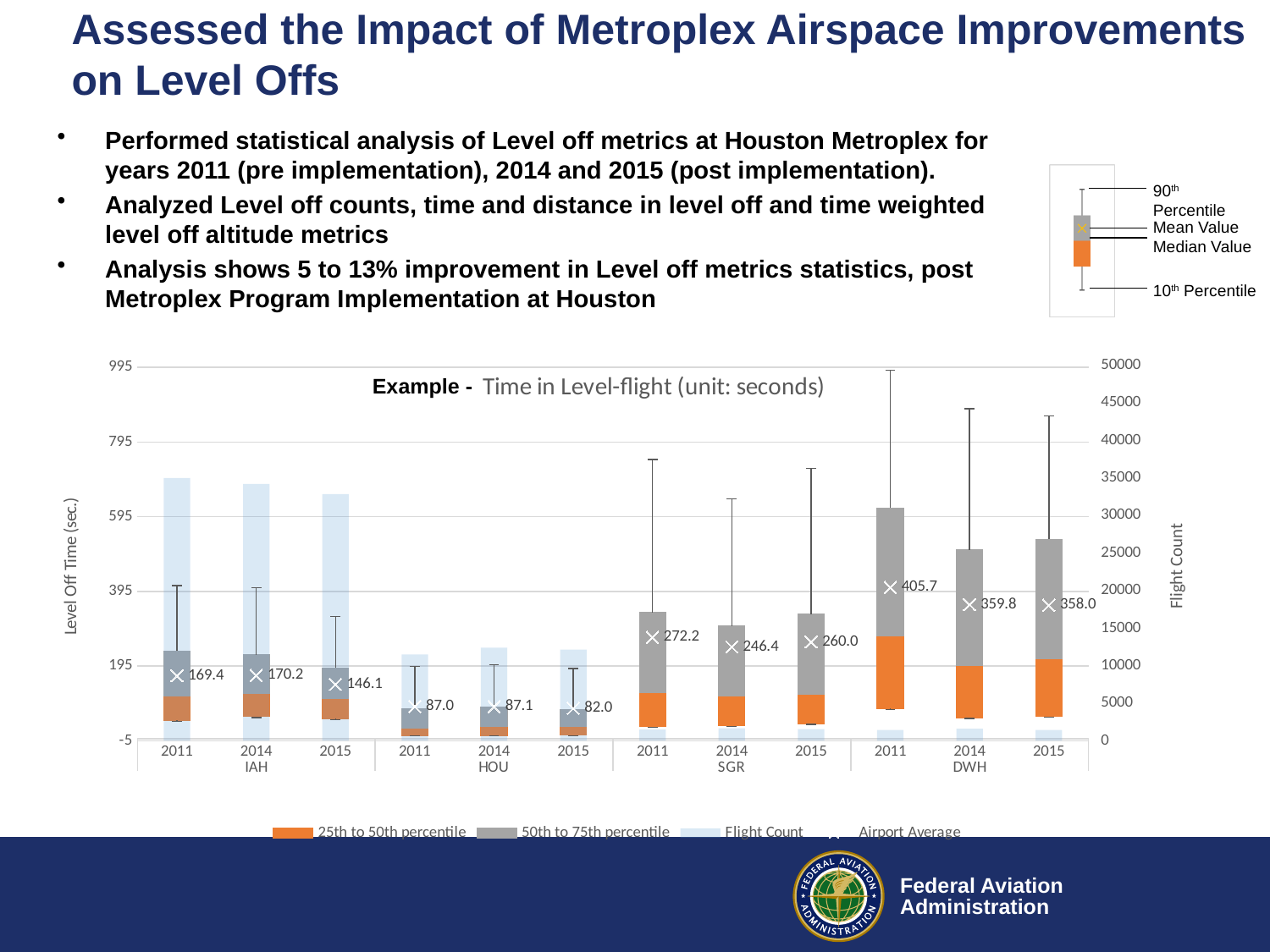
What is the airport average for SGR in 2015? 260.0 Which airport and year has the highest airport average time in level-flight? DWH 2011 What is the airport average for DWH in 2014? 359.8 Does the airport average for DWH rise or fall from 2011 to 2015? falls What is the label of the right-hand vertical axis of the chart? Flight Count What is the airport average time in level-flight for IAH in 2011? 169.4 How many airport-year bars are plotted in the chart? 12 Which is larger, the SGR airport average in 2011 or in 2014? 2011 How many entries does the chart legend list? 4 What is the difference between the DWH airport average in 2011 and in 2015? 47.7 Is the flight count for IAH in 2011 greater or less than 30000? greater Which airport and year has the lowest airport average time in level-flight? HOU 2015